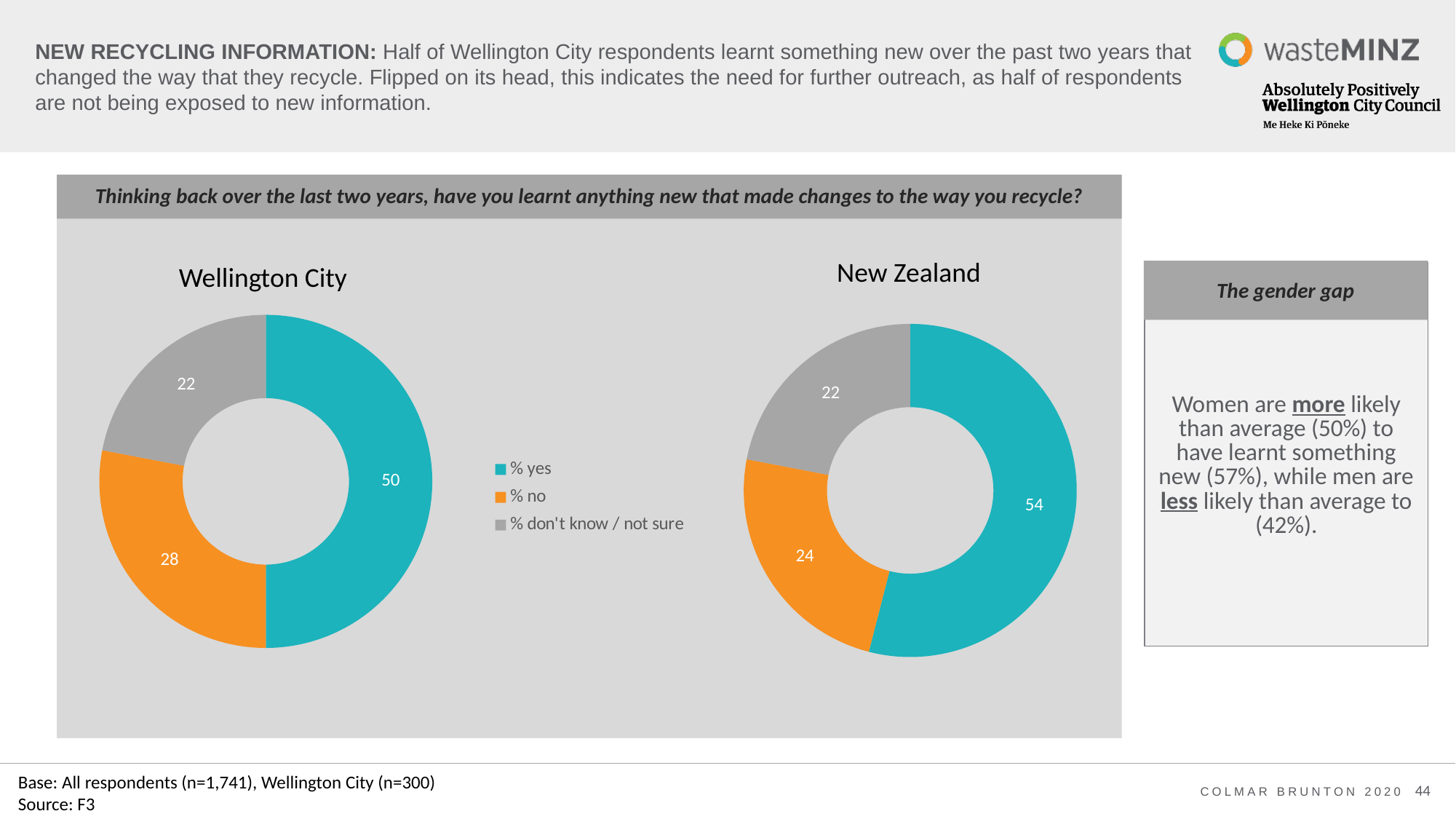
What is the difference between the % yes values in the New Zealand chart and the Wellington City chart? 4 Is the % no value larger in the Wellington City chart or the New Zealand chart? Wellington City In the Wellington City chart, what is the difference between % no and % don't know / not sure? 6 What colour represents % no in the legend? Orange In the New Zealand chart, which category has the smallest slice? % don't know / not sure In the New Zealand chart, what is the value for % no? 24 In the Wellington City chart, what is the value for % yes? 50 How many slices does the Wellington City chart have? 3 In the Wellington City chart, which category has the largest slice? % yes How many series does the legend list? 3 What kind of chart is the New Zealand chart? Doughnut chart In the New Zealand chart, what is the value for % don't know / not sure? 22